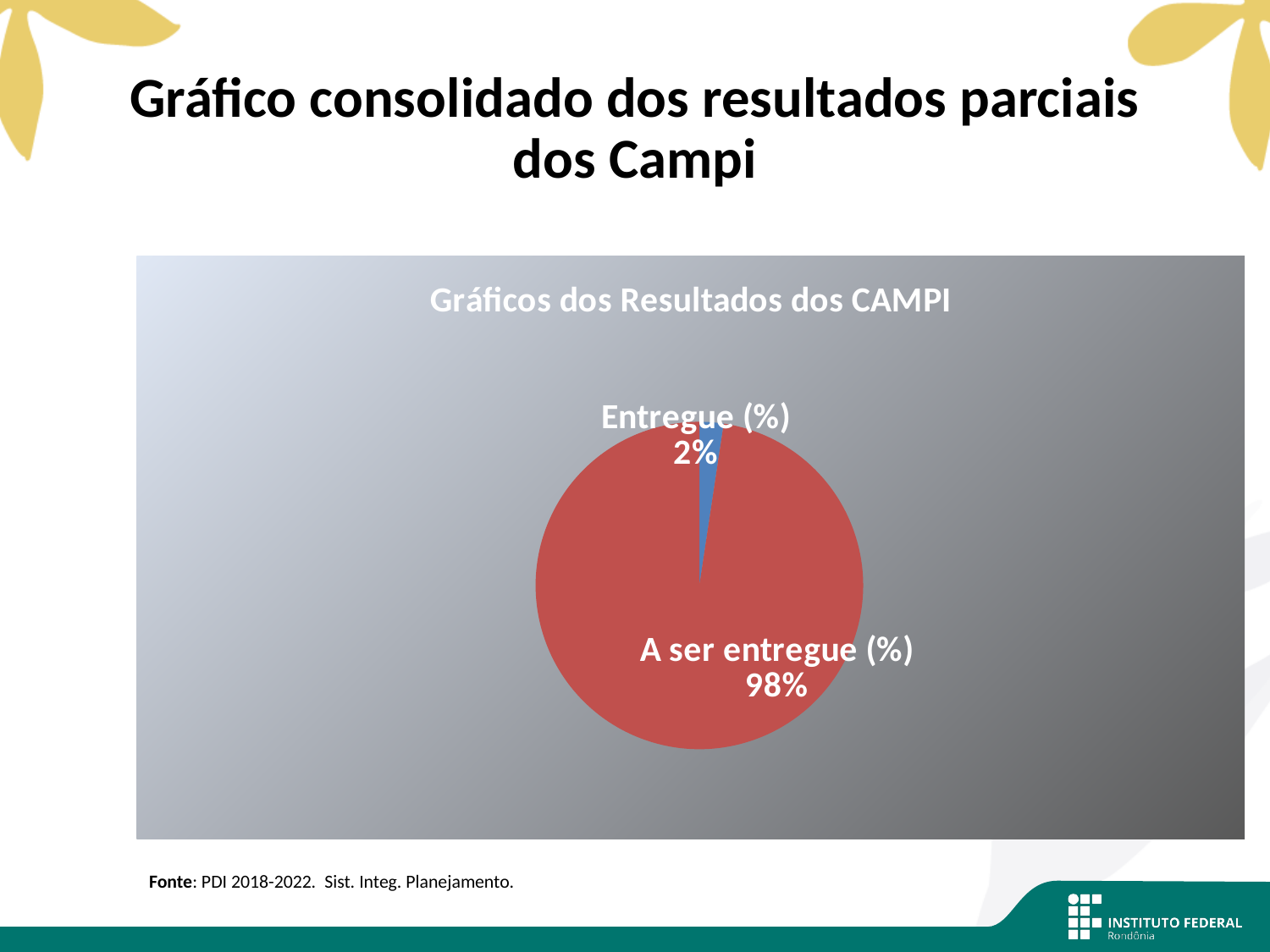
What colour is the "A ser entregue (%)" slice? red What kind of chart is shown on the slide? pie chart Which slice of the pie is the smallest? Entregue (%) Which is larger, the share for "Entregue (%)" or the share for "A ser entregue (%)"? A ser entregue (%) What is the title of the chart? Gráficos dos Resultados dos CAMPI What is the difference in percentage points between "A ser entregue (%)" and "Entregue (%)"? 96 Which slice of the pie is the largest? A ser entregue (%) What share of the pie does "A ser entregue (%)" represent? 98% What share of the pie does "Entregue (%)" represent? 2% How many slices does the pie chart have? 2